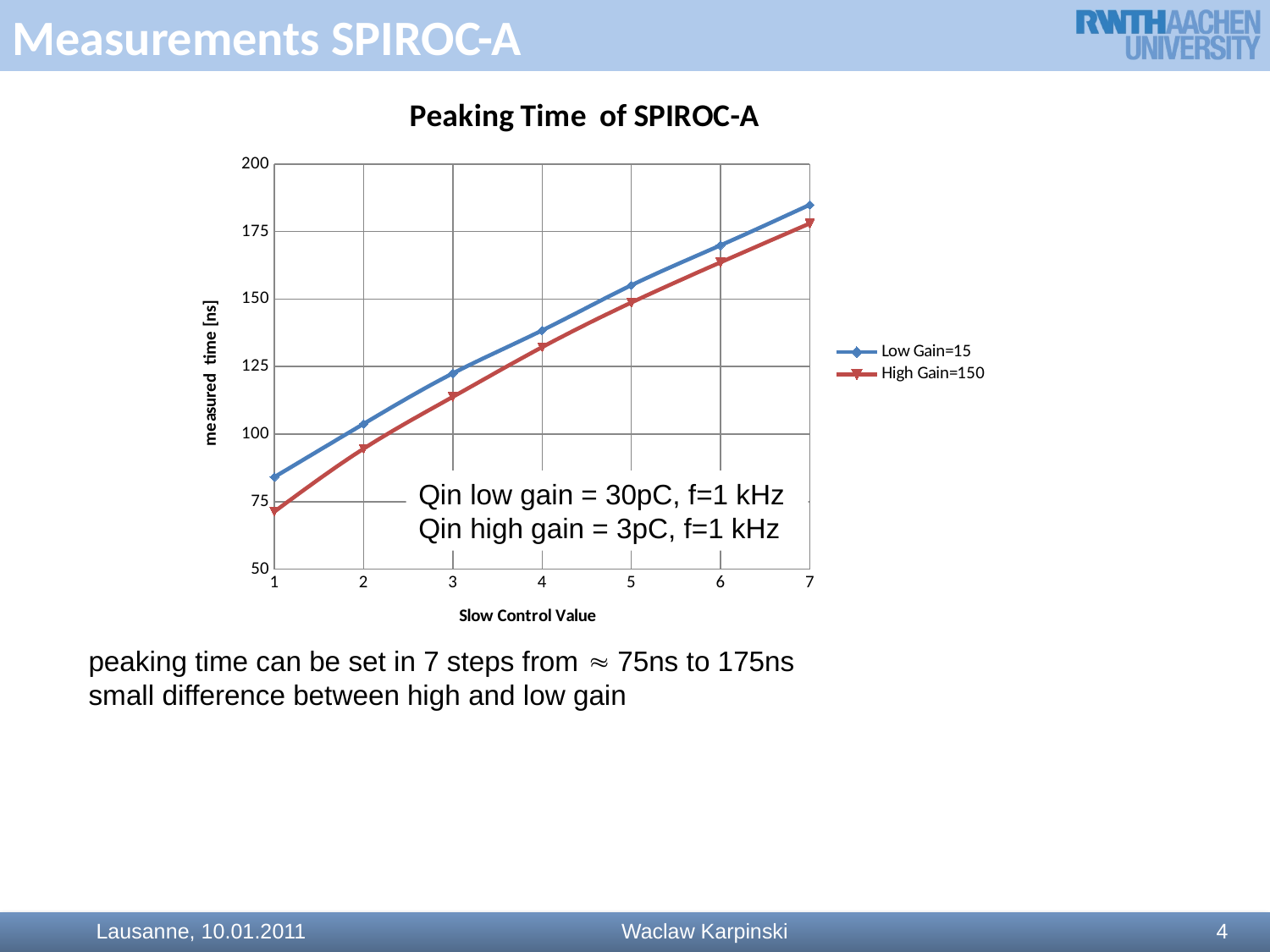
What kind of chart is shown on the slide? line chart Is the High Gain=150 measured time at slow control value 6 greater or less than 150? greater How many series does the legend list? 2 At slow control value 4, which series has the larger measured time, Low Gain=15 or High Gain=150? Low Gain=15 What is the title of the chart? Peaking Time of SPIROC-A At which slow control value is the High Gain=150 measured time lowest? 1 Is the Low Gain=15 measured time at slow control value 7 greater or less than 175? greater Is the Low Gain=15 measured time at slow control value 4 greater or less than 125? greater At which slow control value is the Low Gain=15 measured time highest? 7 How many slow control values are plotted for each series? 7 Do the measured times rise or fall as the slow control value increases? rise